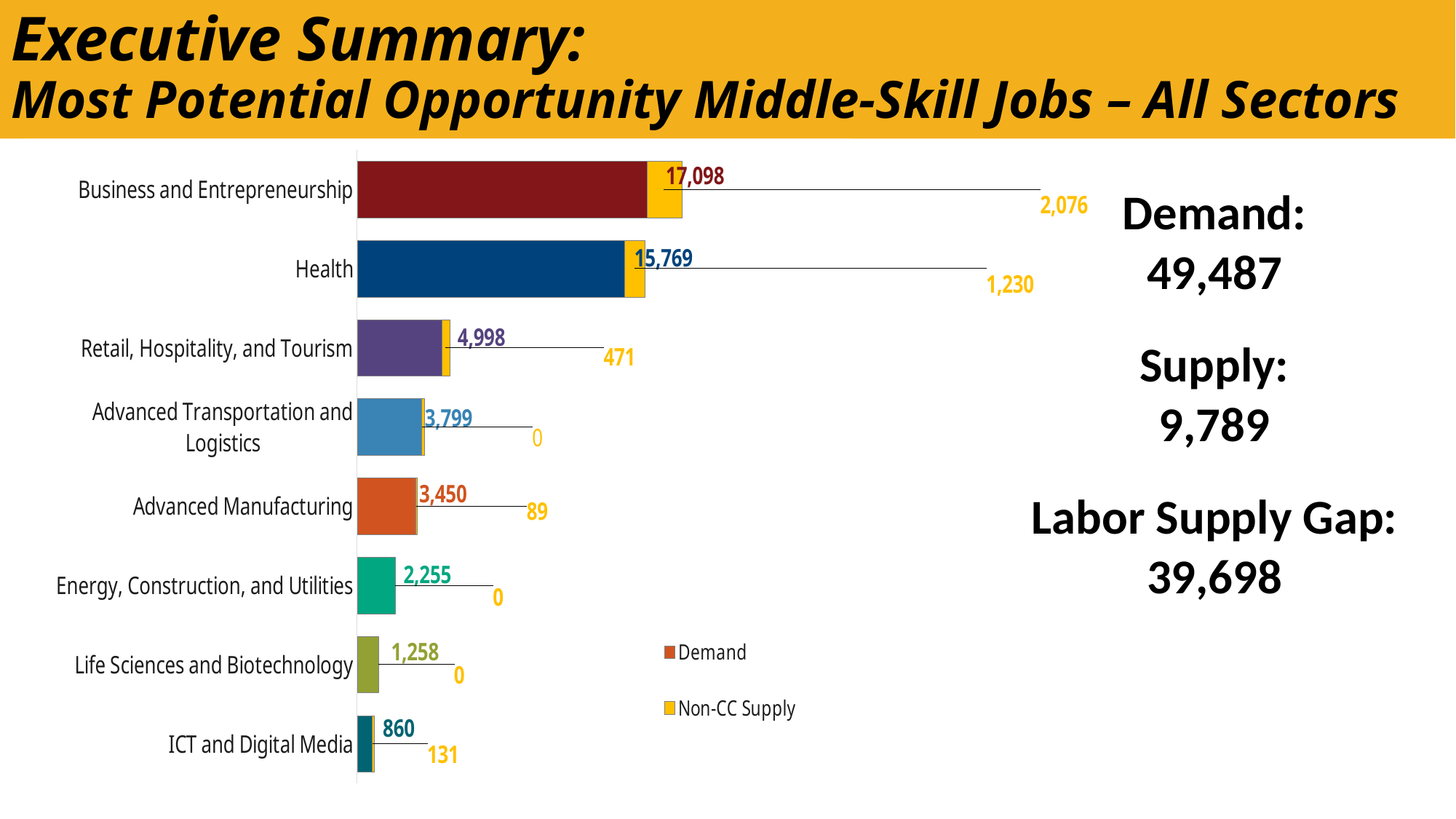
What kind of chart is shown on the slide? Stacked bar chart What is the Demand value for Advanced Manufacturing? 3,450 Which sector has the lowest Demand? ICT and Digital Media Which sector has the highest Demand? Business and Entrepreneurship What is the Demand value for Health? 15,769 How many sectors are shown in the chart? 8 How many series does the legend list? 2 What is the difference between the Demand for Business and Entrepreneurship and the Demand for Health? 1,329 What is the total of the stacked bar for Health (Demand plus Non-CC Supply)? 16,999 Which is larger, the Non-CC Supply for Retail, Hospitality, and Tourism or the Non-CC Supply for Advanced Manufacturing? Retail, Hospitality, and Tourism What is the Non-CC Supply value for Business and Entrepreneurship? 2,076 What is the Non-CC Supply value for ICT and Digital Media? 131